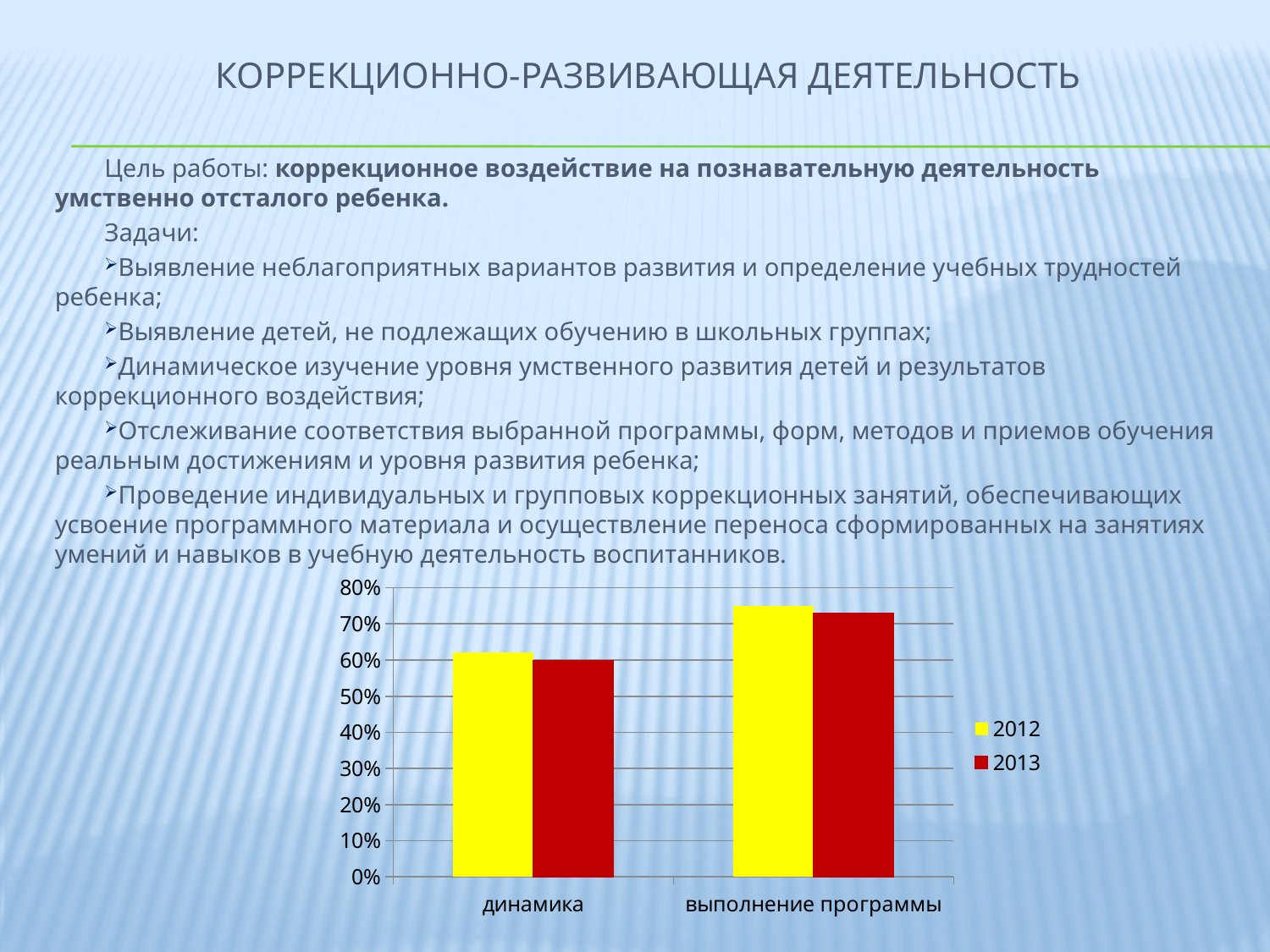
How many categories are shown on the x axis of the chart? 2 Is the 2012 value for выполнение программы greater or less than 70%? greater Is the 2012 value for динамика greater or less than 70%? less Is the 2013 value for динамика greater or less than 50%? greater Which category has the highest bars in the chart? выполнение программы For the 2013 series, which is larger: динамика or выполнение программы? выполнение программы How many series does the chart legend list? 2 What colour are the bars for the 2013 series? red For the 2012 series, which is larger: динамика or выполнение программы? выполнение программы Which category has the lowest bars in the chart? динамика Which series are listed in the chart legend? 2012 and 2013 What kind of chart is shown on the slide? bar chart